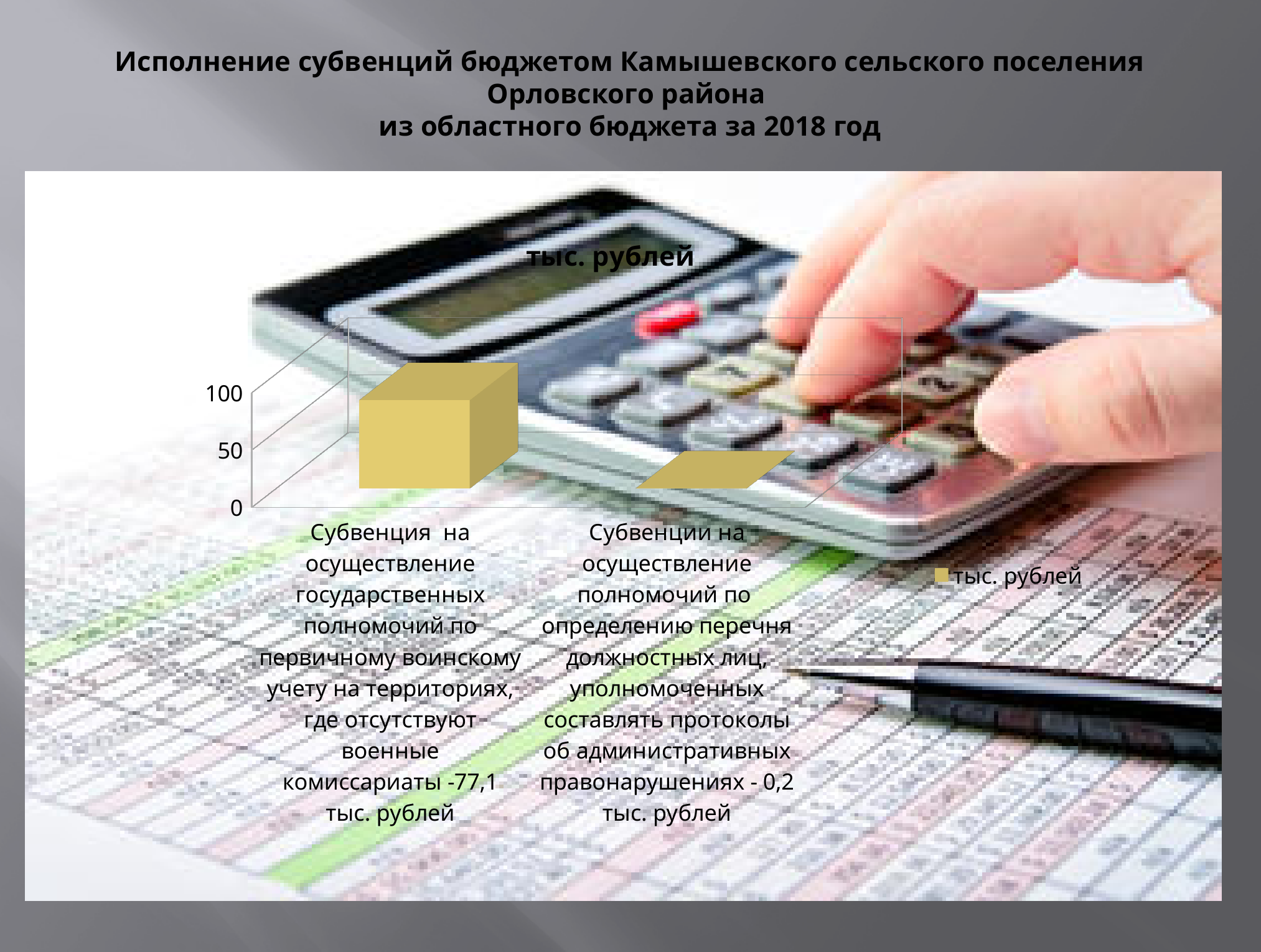
Which is larger: the subvention for primary military registration or the subvention for administrative offence protocols? Subvention for primary military registration Which category has the highest value? Субвенция на осуществление государственных полномочий по первичному воинскому учету How many series does the legend list? 1 What is the difference between the value for primary military registration and the value for administrative offence protocols? 76,9 тыс. рублей What is the value for the subvention for primary military registration (Субвенция на осуществление государственных полномочий по первичному воинскому учету)? 77,1 тыс. рублей What kind of chart is shown on the slide? bar chart How many categories does the chart show? 2 What is the value for the subvention for determining the list of officials authorised to draw up protocols on administrative offences? 0,2 тыс. рублей Which category has the lowest value? Субвенции на осуществление полномочий по определению перечня должностных лиц, уполномоченных составлять протоколы об административных правонарушениях What is the legend entry shown on the chart? тыс. рублей What is the title of the chart? тыс. рублей Is the value for the primary military registration subvention greater or less than 50? greater